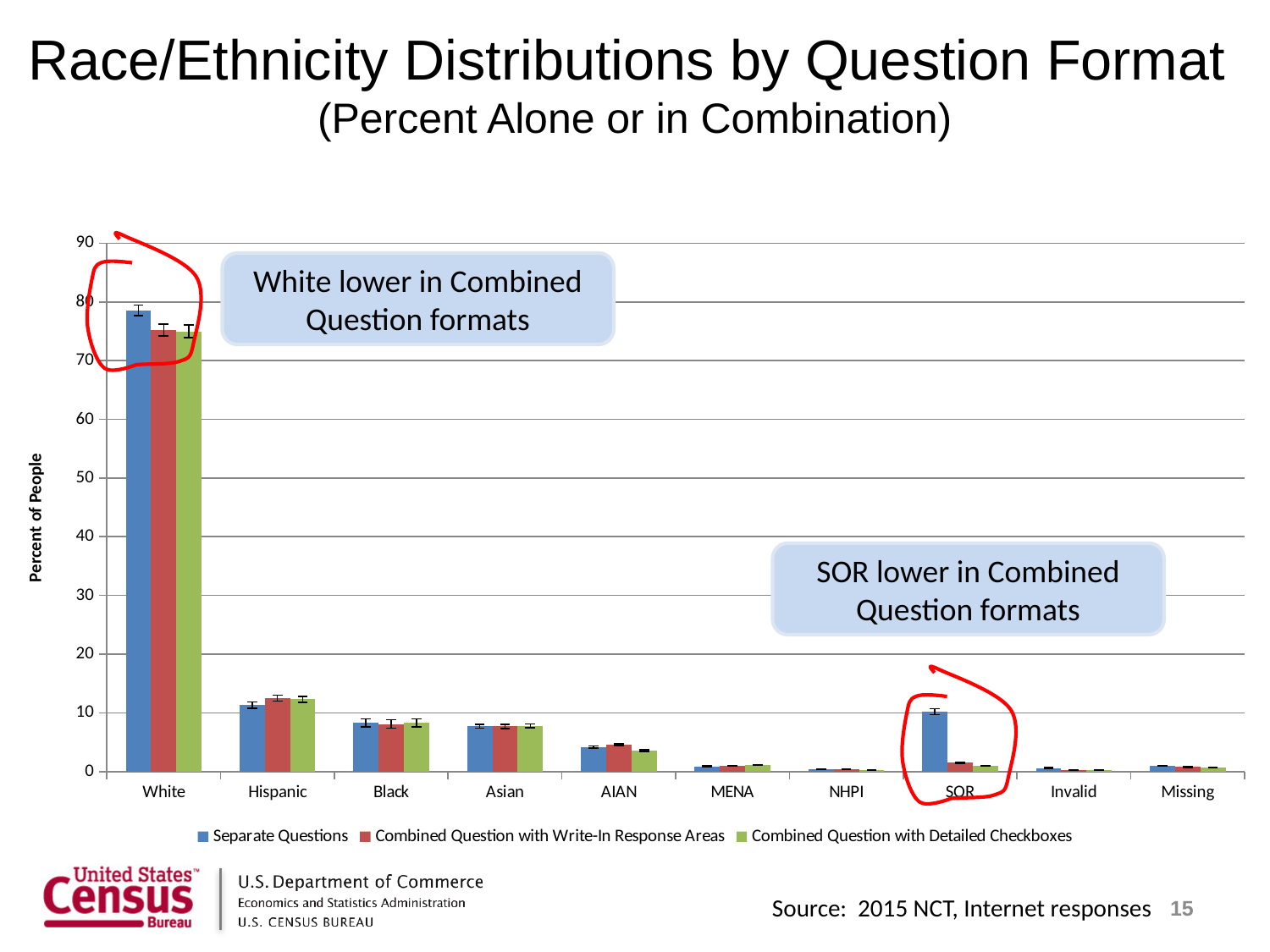
How many series does the legend list? 3 What is the label on the y axis? Percent of People How many race/ethnicity categories are shown along the x axis? 10 Which category has the highest value for Separate Questions? White For SOR, which is larger: Separate Questions or Combined Question with Write-In Response Areas? Separate Questions What is the third series listed in the legend? Combined Question with Detailed Checkboxes Is the Separate Questions value for White greater or less than 70? greater Is the Separate Questions value for Hispanic greater or less than 20? less What kind of chart is shown on the slide? Bar chart Is the Separate Questions value for SOR greater or less than 5? greater For White, which is larger: Separate Questions or Combined Question with Write-In Response Areas? Separate Questions